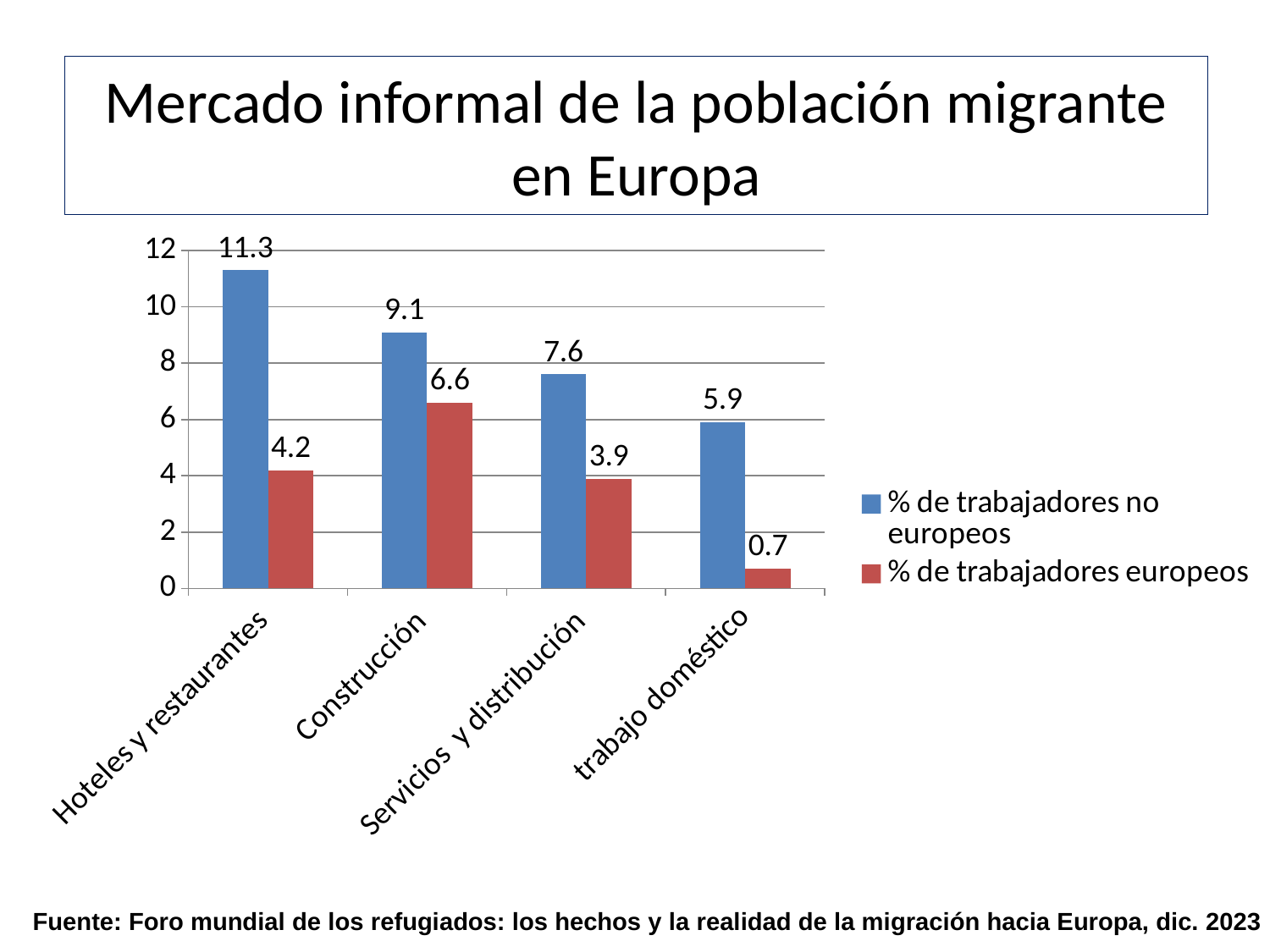
What is the value for '% de trabajadores no europeos' in Hoteles y restaurantes? 11.3 Which is larger in Construcción: '% de trabajadores no europeos' or '% de trabajadores europeos'? % de trabajadores no europeos Which category has the highest value for '% de trabajadores no europeos'? Hoteles y restaurantes What is the value for '% de trabajadores europeos' in Construcción? 6.6 Do the values for '% de trabajadores no europeos' rise or fall from left to right along the x axis? fall How many series does the legend list? 2 What is the difference between '% de trabajadores no europeos' and '% de trabajadores europeos' in Servicios y distribución? 3.7 Which category has the lowest value for '% de trabajadores europeos'? trabajo doméstico How many categories are shown on the x axis? 4 Is the value for '% de trabajadores no europeos' in trabajo doméstico greater or less than 4? greater What is the value for '% de trabajadores europeos' in trabajo doméstico? 0.7 What kind of chart is shown on the slide? bar chart